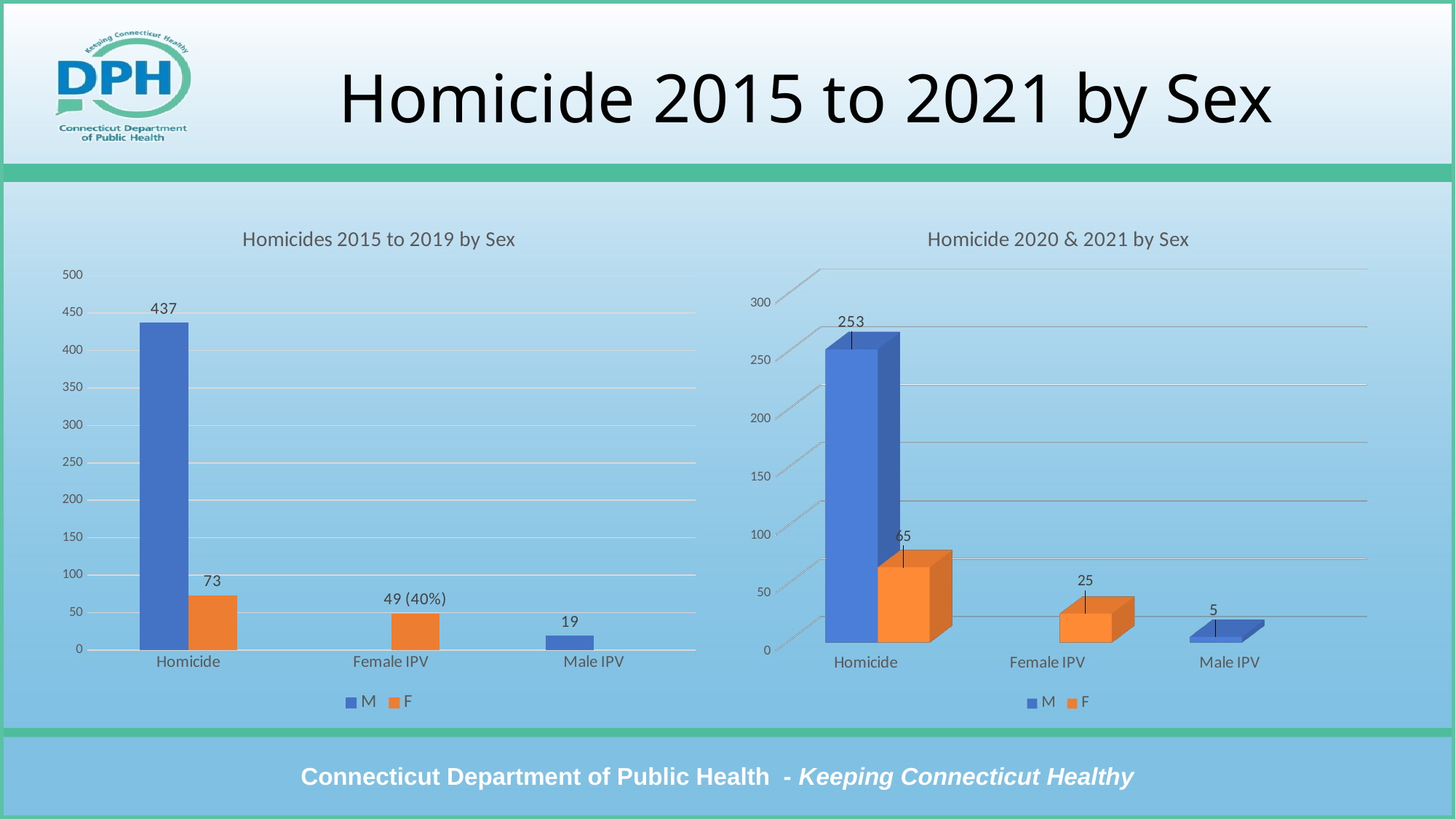
In the 'Homicide 2020 & 2021 by Sex' chart, what is the value for Female IPV? 25 What kind of chart is the 'Homicide 2020 & 2021 by Sex' chart? Bar chart In the 'Homicide 2020 & 2021 by Sex' chart, what is the value for F in the Homicide category? 65 In the 'Homicide 2020 & 2021 by Sex' chart, which is larger: the Female IPV value or the Male IPV value? Female IPV In the 'Homicides 2015 to 2019 by Sex' chart, what is the value for F in the Homicide category? 73 In the 'Homicide 2020 & 2021 by Sex' chart, what is the value for Male IPV? 5 How many series does the legend list in the 'Homicides 2015 to 2019 by Sex' chart? 2 In the 'Homicide 2020 & 2021 by Sex' chart, what is the value for M in the Homicide category? 253 In the 'Homicides 2015 to 2019 by Sex' chart, what is the value for M in the Homicide category? 437 In the 'Homicides 2015 to 2019 by Sex' chart, what data label is shown on the Female IPV bar? 49 (40%) In the 'Homicides 2015 to 2019 by Sex' chart, what is the difference between the M and F values in the Homicide category? 364 In the 'Homicides 2015 to 2019 by Sex' chart, what is the value for Male IPV? 19